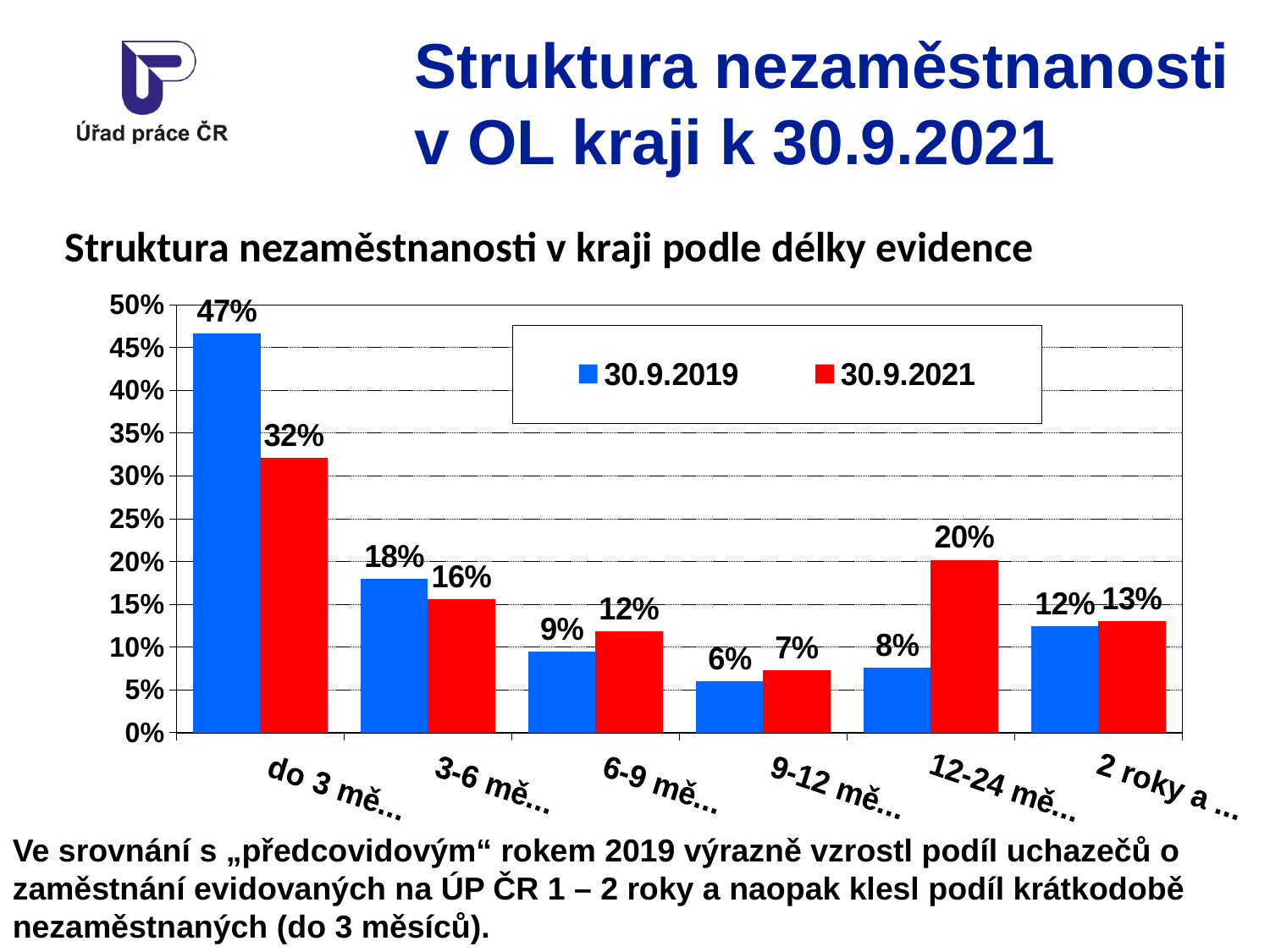
How many categories are shown on the x axis? 6 Which category has the highest value for the 30.9.2021 series? do 3 mě… What is the difference between the 30.9.2019 and 30.9.2021 values in the "do 3 mě…" category? 15% What is the value for 30.9.2021 in the "12-24 mě…" category? 20% How many series does the legend list? 2 In the "3-6 mě…" category, which series has the larger value, 30.9.2019 or 30.9.2021? 30.9.2019 What is the value for 30.9.2021 in the "6-9 mě…" category? 12% What is the difference between the 30.9.2021 and 30.9.2019 values in the "12-24 mě…" category? 12% What kind of chart is shown on the slide? Bar chart Which category has the lowest value for the 30.9.2019 series? 9-12 mě… What is the value for 30.9.2019 in the "do 3 mě…" category? 47% Which colour represents the 30.9.2021 series? Red